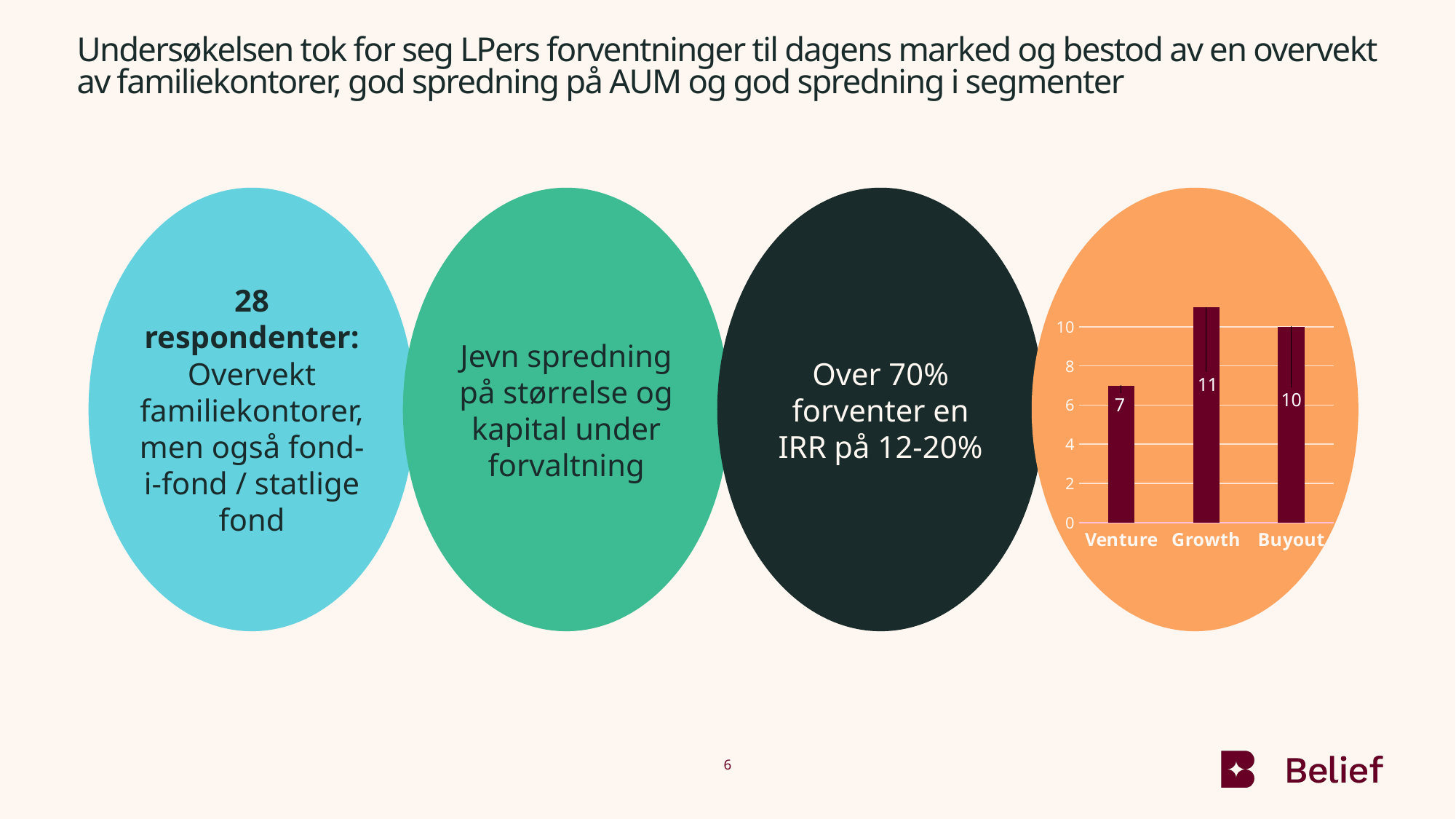
What is the difference between the values for Growth and Venture? 4 What is the value for Venture in the bar chart? 7 Which is larger, the value for Venture or the value for Buyout? Buyout What is the total of the three values in the bar chart? 28 What is the value for Buyout in the bar chart? 10 Is the value for Venture greater or less than 8? less What is the difference between the values for Buyout and Venture? 3 Which category has the highest value in the bar chart? Growth How many categories are shown in the bar chart? 3 Which category has the lowest value in the bar chart? Venture What is the value for Growth in the bar chart? 11 What kind of chart is shown on the slide? bar chart